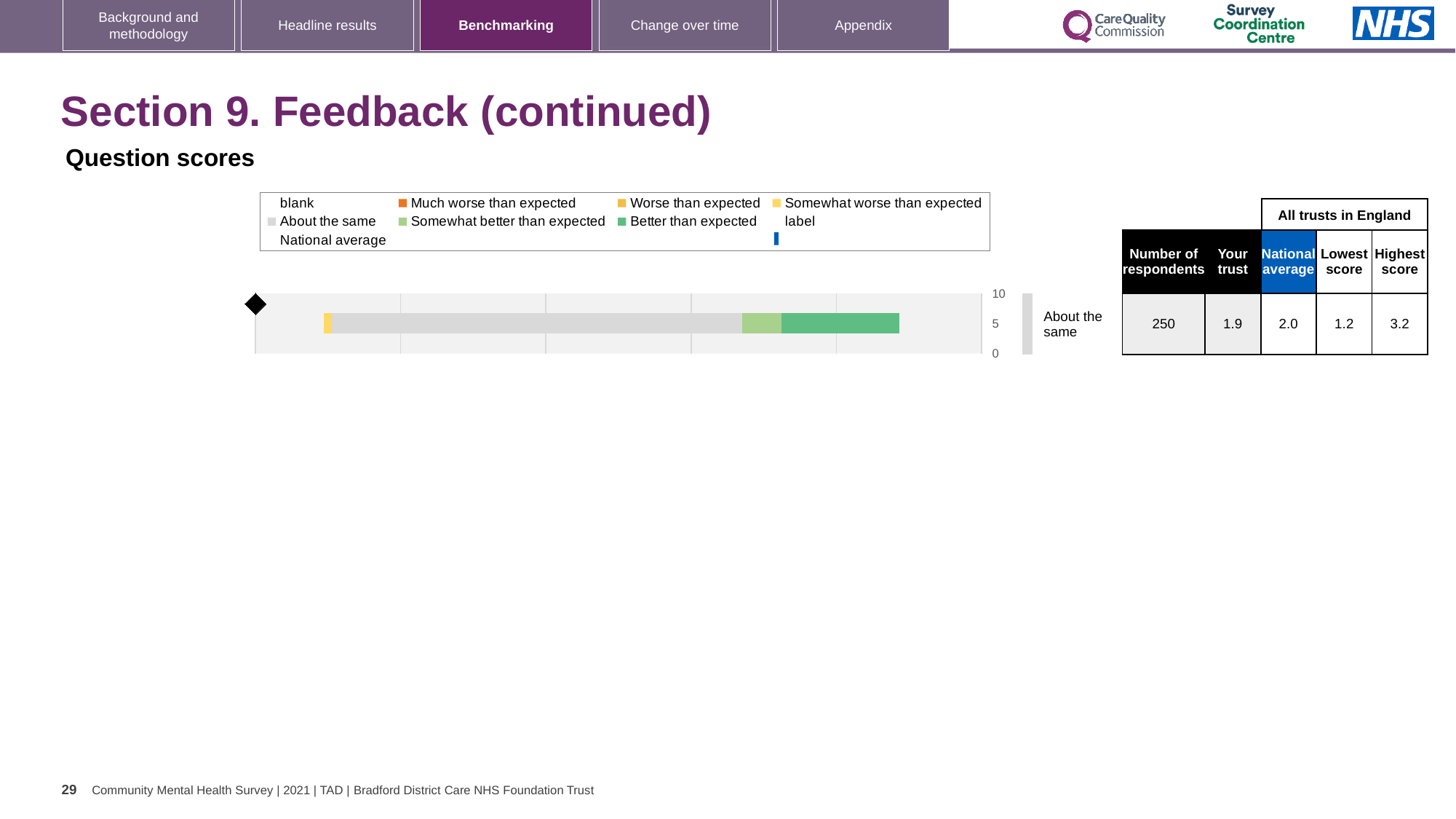
What is the highest value shown on the chart's numeric axis? 10 What is the difference between the Highest score and the Lowest score in the table? 2.0 What is the 'Your trust' score for 'About the same' in the table next to the chart? 1.9 Which is larger for 'About the same': the Your trust score or the National average score? National average What is the label of the single category plotted in the chart? About the same How many question categories are plotted in the chart? 1 What is the National average score shown in the table for 'About the same'? 2.0 How many entries does the chart legend list? 9 How many respondents are listed in the table for 'About the same'? 250 What kind of chart is shown on the slide? bar chart Which legend entry is shown in dark green? Better than expected Which segment of the bar is the widest? About the same